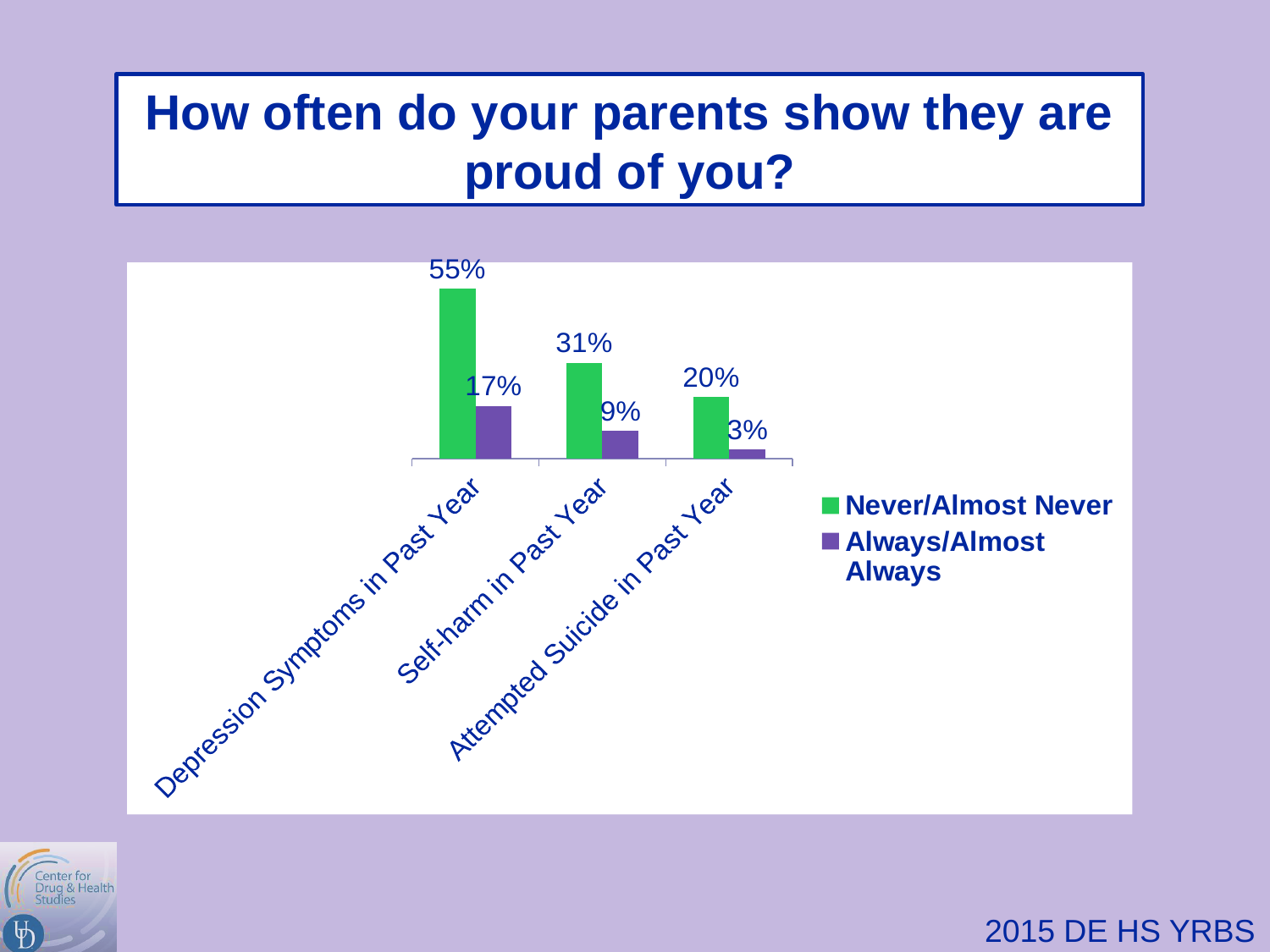
Which category has the highest Never/Almost Never value? Depression Symptoms in Past Year What is the difference between the Never/Almost Never and Always/Almost Always values for Depression Symptoms in Past Year? 38% What is the value for Never/Almost Never for Self-harm in Past Year? 31% What is the value for Never/Almost Never for Depression Symptoms in Past Year? 55% What is the value for Always/Almost Always for Self-harm in Past Year? 9% What is the value for Always/Almost Always for Attempted Suicide in Past Year? 3% Which category has the lowest Always/Almost Always value? Attempted Suicide in Past Year Which is larger for Attempted Suicide in Past Year: Never/Almost Never or Always/Almost Always? Never/Almost Never What kind of chart is shown on the slide? Bar chart How many categories are shown on the x axis? 3 How many series does the legend list? 2 What is the difference between the Never/Almost Never values for Self-harm in Past Year and Attempted Suicide in Past Year? 11%